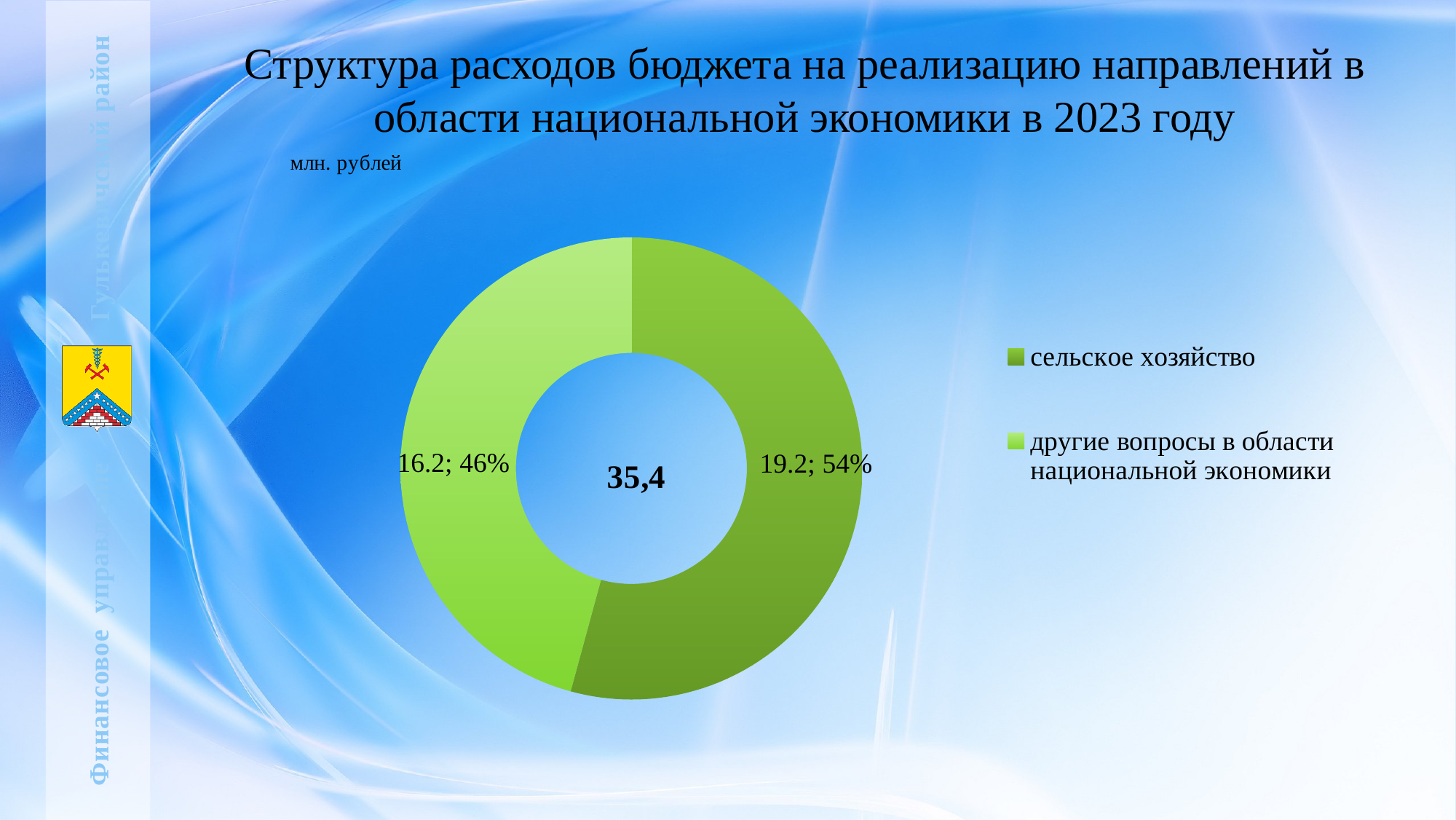
Which is larger: сельское хозяйство or другие вопросы в области национальной экономики? сельское хозяйство What kind of chart is shown on the slide? Doughnut (pie) chart What share of the chart does сельское хозяйство take? 54% Which category has the largest slice? сельское хозяйство What is the difference between the values for сельское хозяйство and другие вопросы в области национальной экономики? 3 How many categories does the chart show? 2 What unit of measurement is indicated for the chart? млн. рублей What share of the chart does другие вопросы в области национальной экономики take? 46% What is the value for другие вопросы в области национальной экономики? 16.2 What total value is shown in the centre of the doughnut? 35,4 Which category has the smallest slice? другие вопросы в области национальной экономики What is the value for сельское хозяйство? 19.2